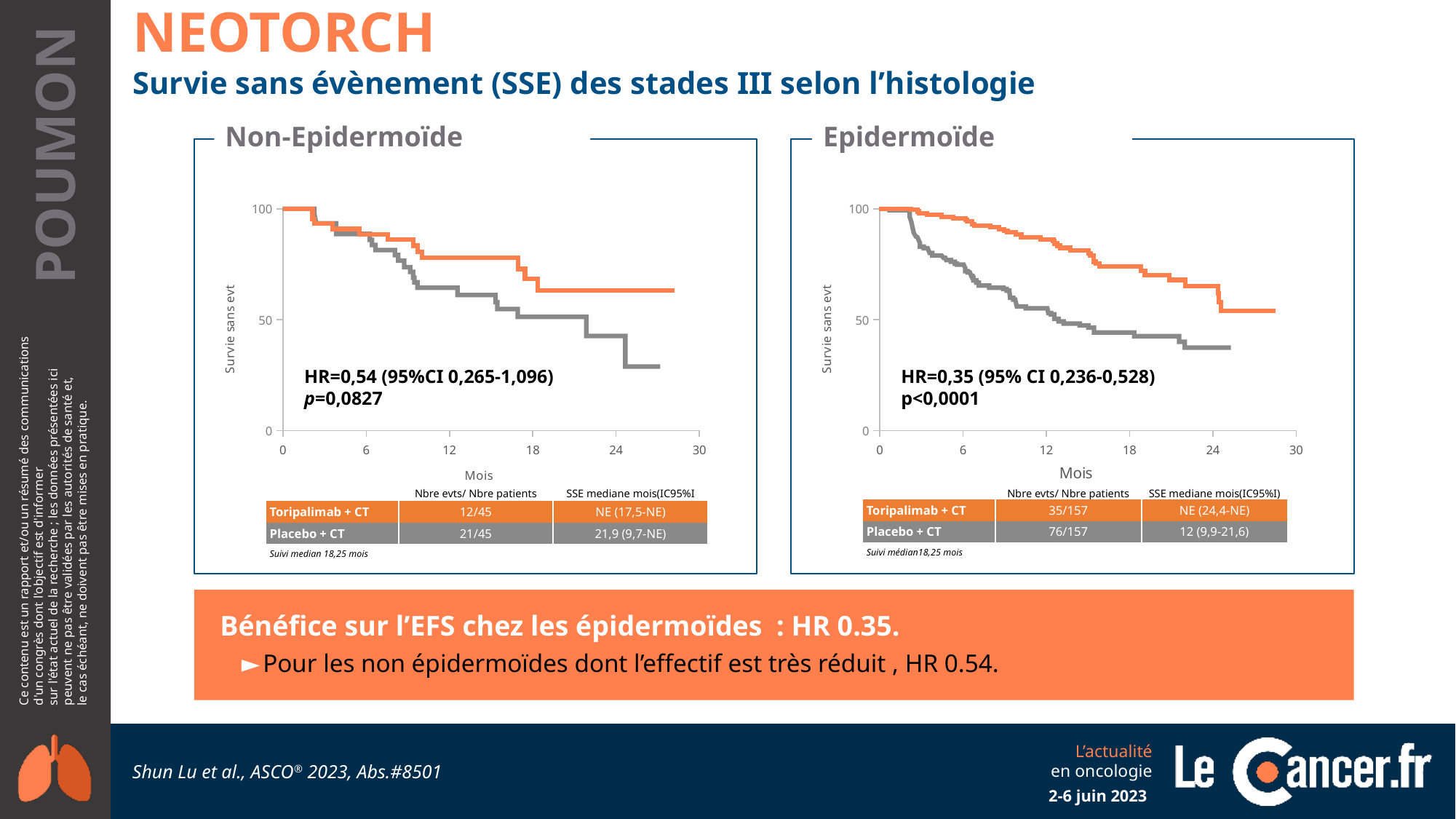
In the Epidermoïde chart, which arm has the higher survival curve at 12 months, Toripalimab + CT or Placebo + CT? Toripalimab + CT In the Non-Epidermoïde chart, what is the p-value printed on the chart? p=0,0827 In the Epidermoïde chart, what is the hazard ratio (HR) printed on the chart? HR=0,35 (95% CI 0,236-0,528) In the Epidermoïde chart, what is the median SSE (months) for Toripalimab + CT? NE (24,4-NE) In the Non-Epidermoïde chart, what colour is the Toripalimab + CT curve? Orange In the Epidermoïde chart, do the survival curves rise or fall as months increase along the x axis? fall In the Non-Epidermoïde chart, is the Placebo + CT survival value at 24 months greater or less than 50? less In the Epidermoïde chart, is the Toripalimab + CT survival value at 24 months greater or less than 50? greater What kind of chart is shown in the Non-Epidermoïde panel? Line chart (Kaplan-Meier survival curves) In the Non-Epidermoïde chart, what is the median SSE (months) for Placebo + CT? 21,9 (9,7-NE) In the Epidermoïde chart, what is the number of events / number of patients for Placebo + CT? 76/157 In the Non-Epidermoïde chart, how many series (treatment arms) are plotted? 2